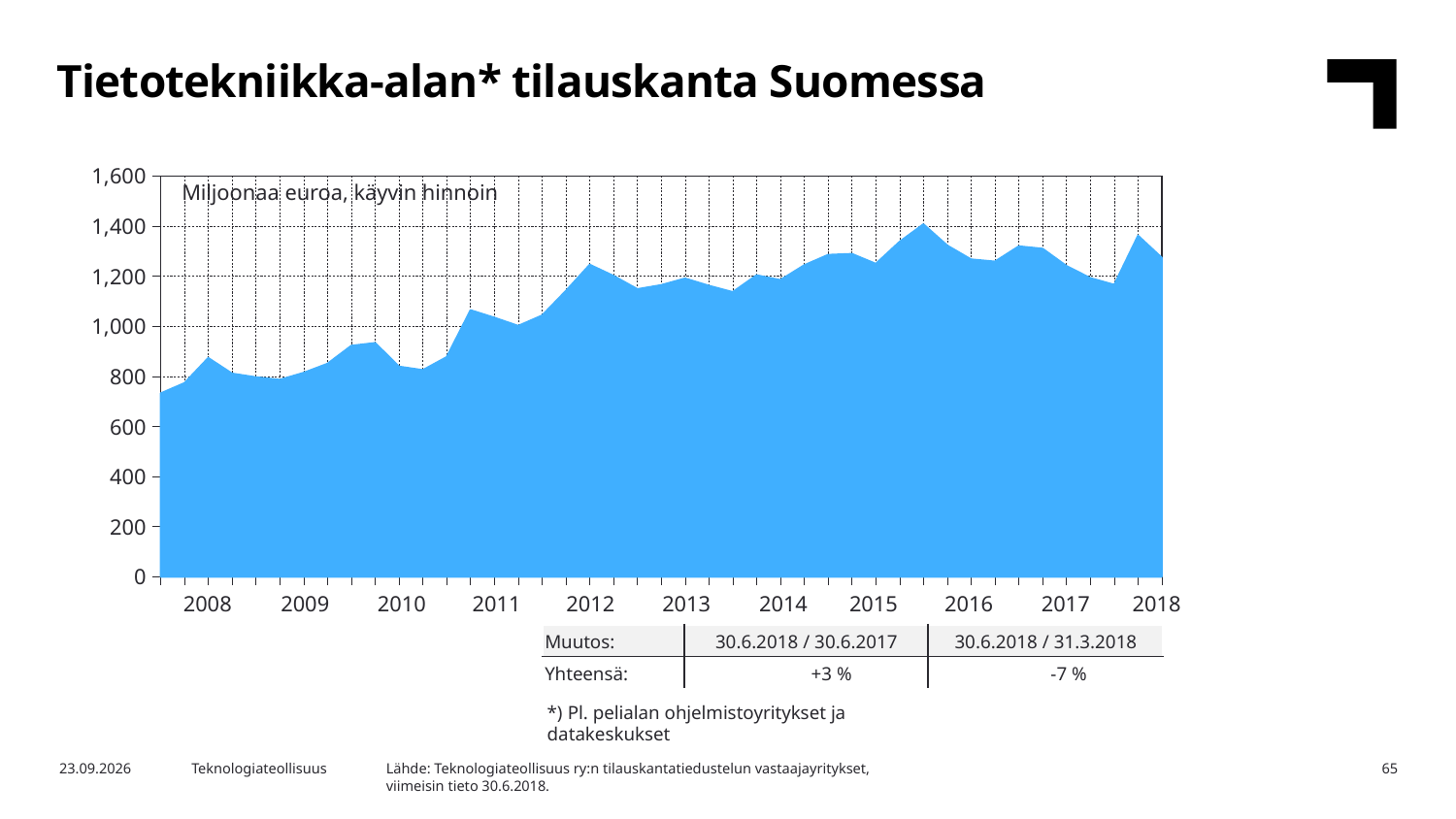
What is the highest value shown on the y axis? 1,600 How many year labels are shown on the x axis? 11 What unit is stated inside the chart area? Miljoonaa euroa, käyvin hinnoin Is the value at the start of 2008 greater or less than 800? less Overall, do the values rise or fall from 2008 to 2018? rise Is the value at the start of 2014 greater or less than 1,000? greater Is the value at the start of 2010 greater or less than 1,000? less What is the title of the chart? Tietotekniikka-alan* tilauskanta Suomessa What kind of chart is shown on the slide? area chart In which year does the chart reach its lowest value? 2008